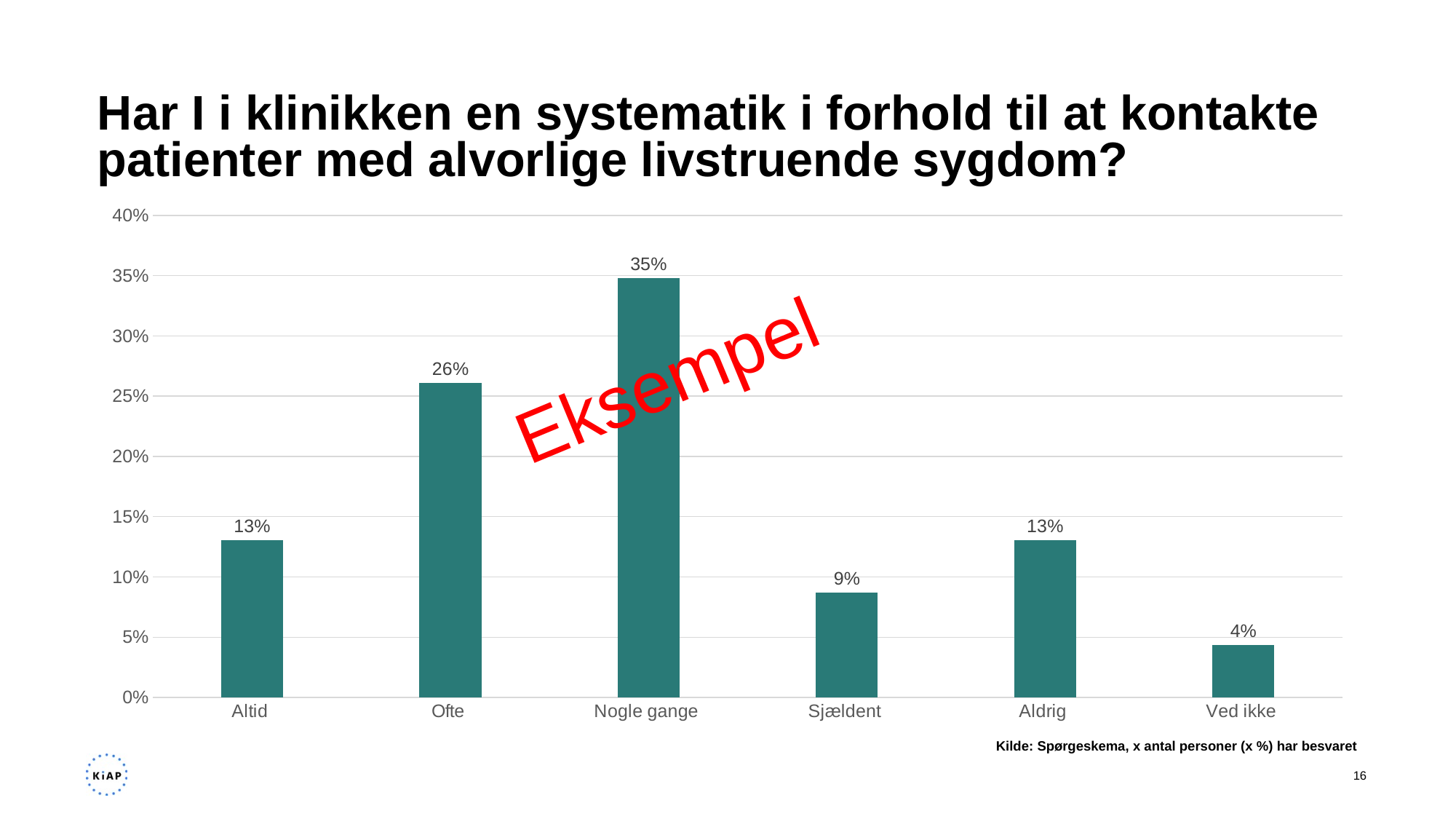
Is the value for Sjældent greater or less than 10%? less What is the value for Ved ikke? 4% Which category has the lowest value? Ved ikke What red word is written diagonally across the chart? Eksempel Which is larger, the value for Ofte or the value for Aldrig? Ofte What kind of chart is shown on the slide? bar chart How many categories are shown on the x axis? 6 What is the difference between the values for Nogle gange and Ofte? 9% What is the value for Ofte? 26% What is the value for Sjældent? 9% What is the value for Nogle gange? 35% Which category has the highest value? Nogle gange